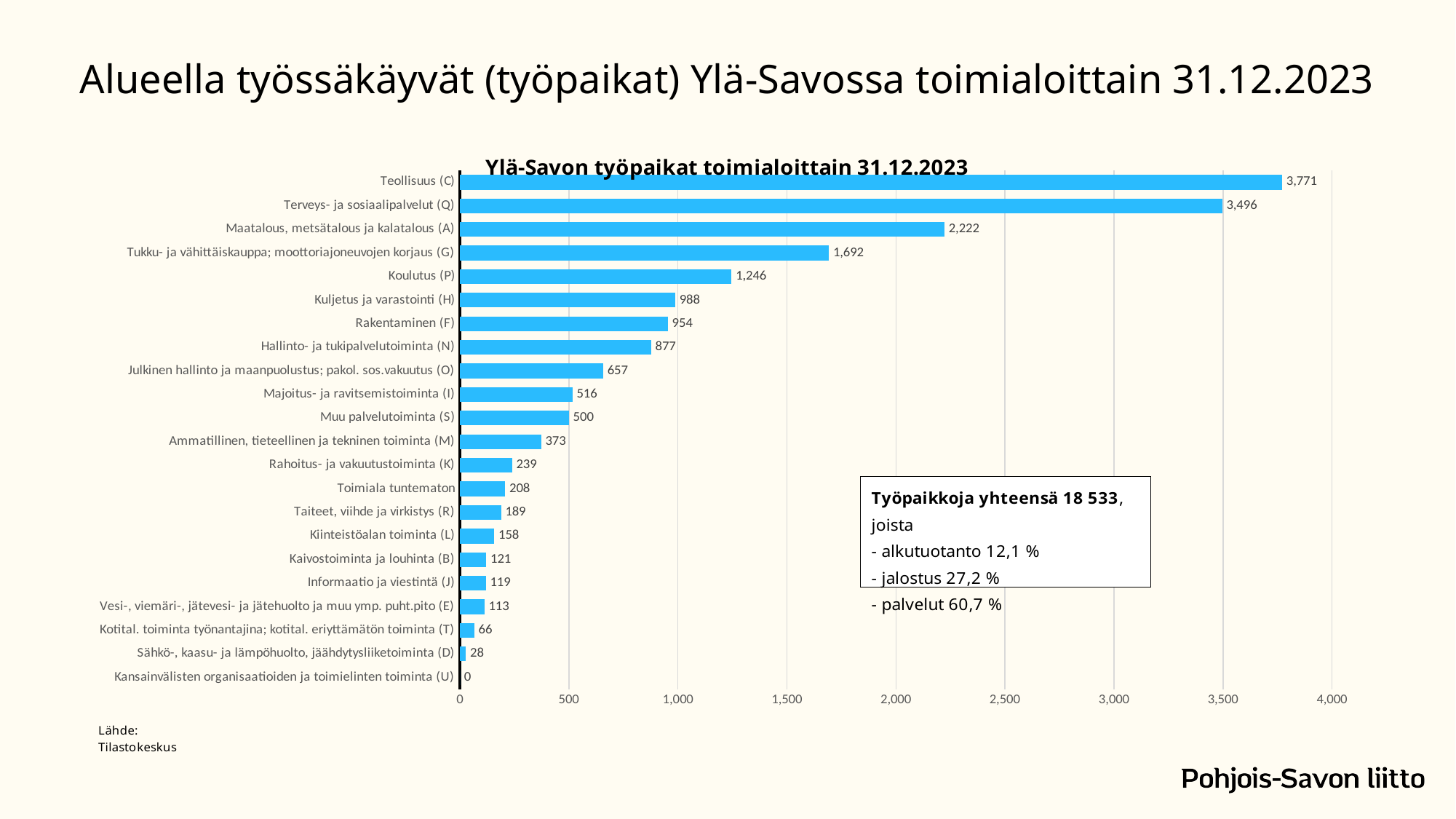
Which category has the lowest value? Kansainvälisten organisaatioiden ja toimielinten toiminta (U) What is the value for Teollisuus (C)? 3,771 What is the difference between Maatalous, metsätalous ja kalatalous (A) and Tukku- ja vähittäiskauppa; moottoriajoneuvojen korjaus (G)? 530 What kind of chart is shown on the slide? bar chart What is the title of the chart? Ylä-Savon työpaikat toimialoittain 31.12.2023 What is the difference between Teollisuus (C) and Terveys- ja sosiaalipalvelut (Q)? 275 What is the value for Koulutus (P)? 1,246 What is the value for Rahoitus- ja vakuutustoiminta (K)? 239 Which category has the highest value? Teollisuus (C) Which is larger, Kuljetus ja varastointi (H) or Rakentaminen (F)? Kuljetus ja varastointi (H) Is the value for Hallinto- ja tukipalvelutoiminta (N) greater or less than 1,000? less How many categories are shown in the chart? 22